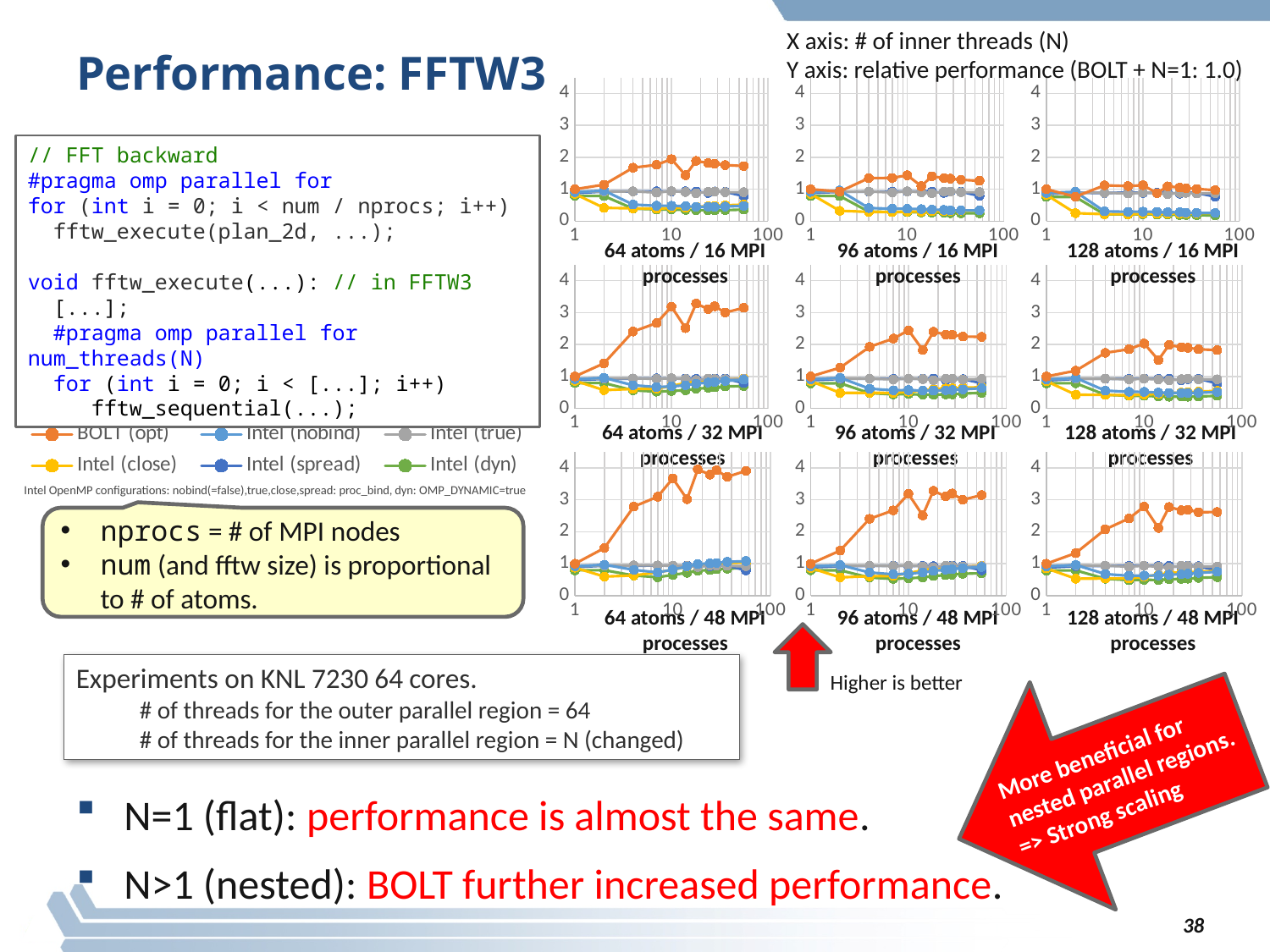
In the '64 atoms / 48 MPI processes' chart, which series has the highest value at the largest N? BOLT (opt) In the '64 atoms / 48 MPI processes' chart, does the BOLT (opt) series generally rise or fall as N increases? rise In the '96 atoms / 16 MPI processes' chart, is the highest value reached by BOLT (opt) greater or less than 2? less In the '64 atoms / 16 MPI processes' chart, is the highest value reached by BOLT (opt) greater or less than 3? less How many small charts are shown in the grid on the slide? 9 How many series does the legend list for the charts? 6 In the '64 atoms / 48 MPI processes' chart, is the value for BOLT (opt) at the largest N greater or less than 3? greater What kind of chart is used in the 3x3 grid of plots on the slide? line chart Which series are listed in the legend of the charts? BOLT (opt), Intel (nobind), Intel (true), Intel (close), Intel (spread), Intel (dyn) In the '96 atoms / 48 MPI processes' chart, which series has the highest value at the largest N? BOLT (opt)